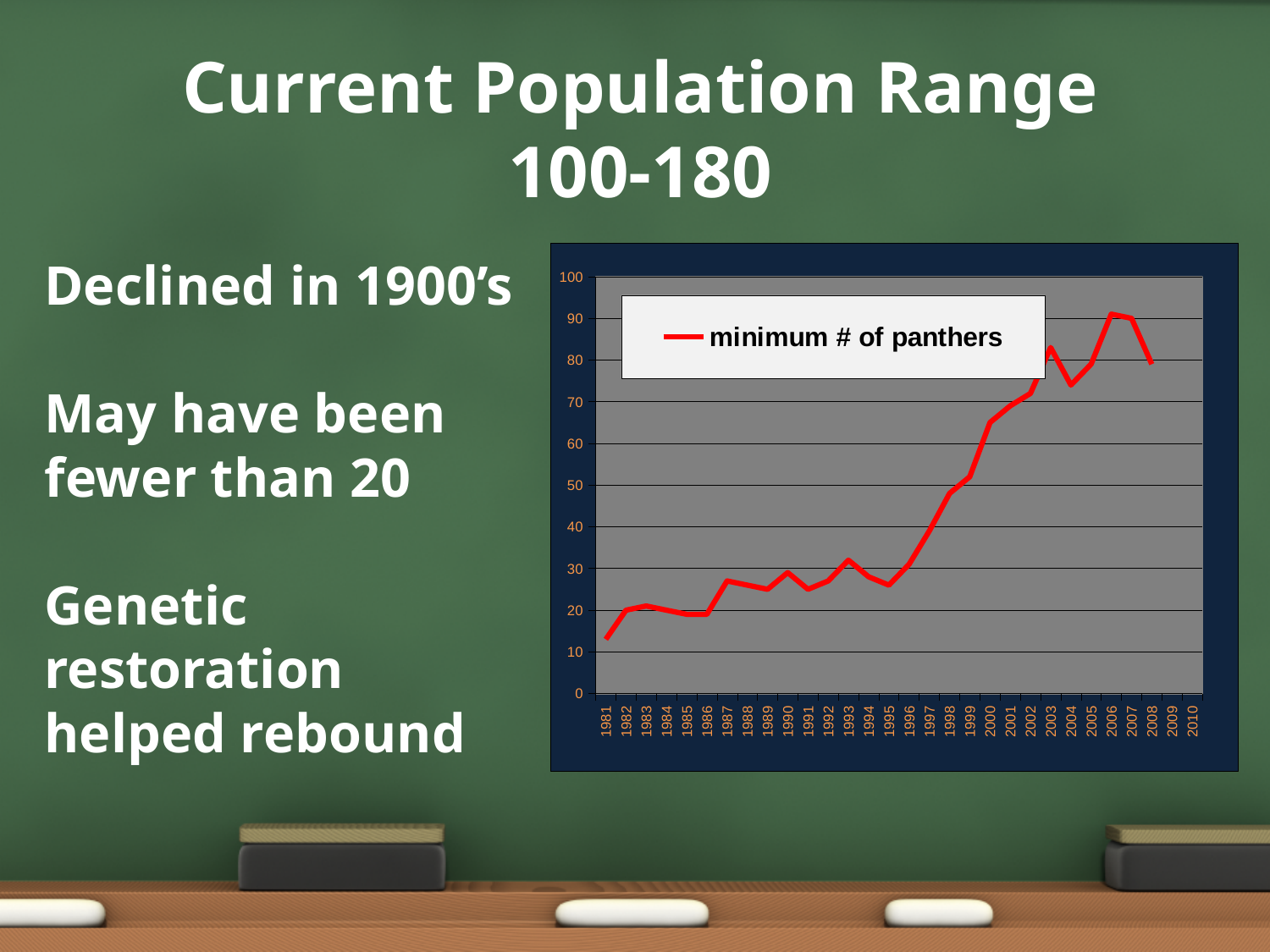
Which year has the larger minimum # of panthers, 1990 or 2003? 2003 How many year labels are shown along the x axis of the chart? 30 Is the value for 2006 greater or less than 80? greater What colour is the line plotted in the chart? red Is the value for 1981 greater or less than 20? less How many series does the chart's legend list? 1 Overall, does the minimum # of panthers rise or fall from 1981 to 2008? rise What kind of chart is shown on the slide? line chart Is the value for 2000 greater or less than 60? greater What is the name of the series shown in the chart's legend? minimum # of panthers Which year has the lowest minimum # of panthers? 1981